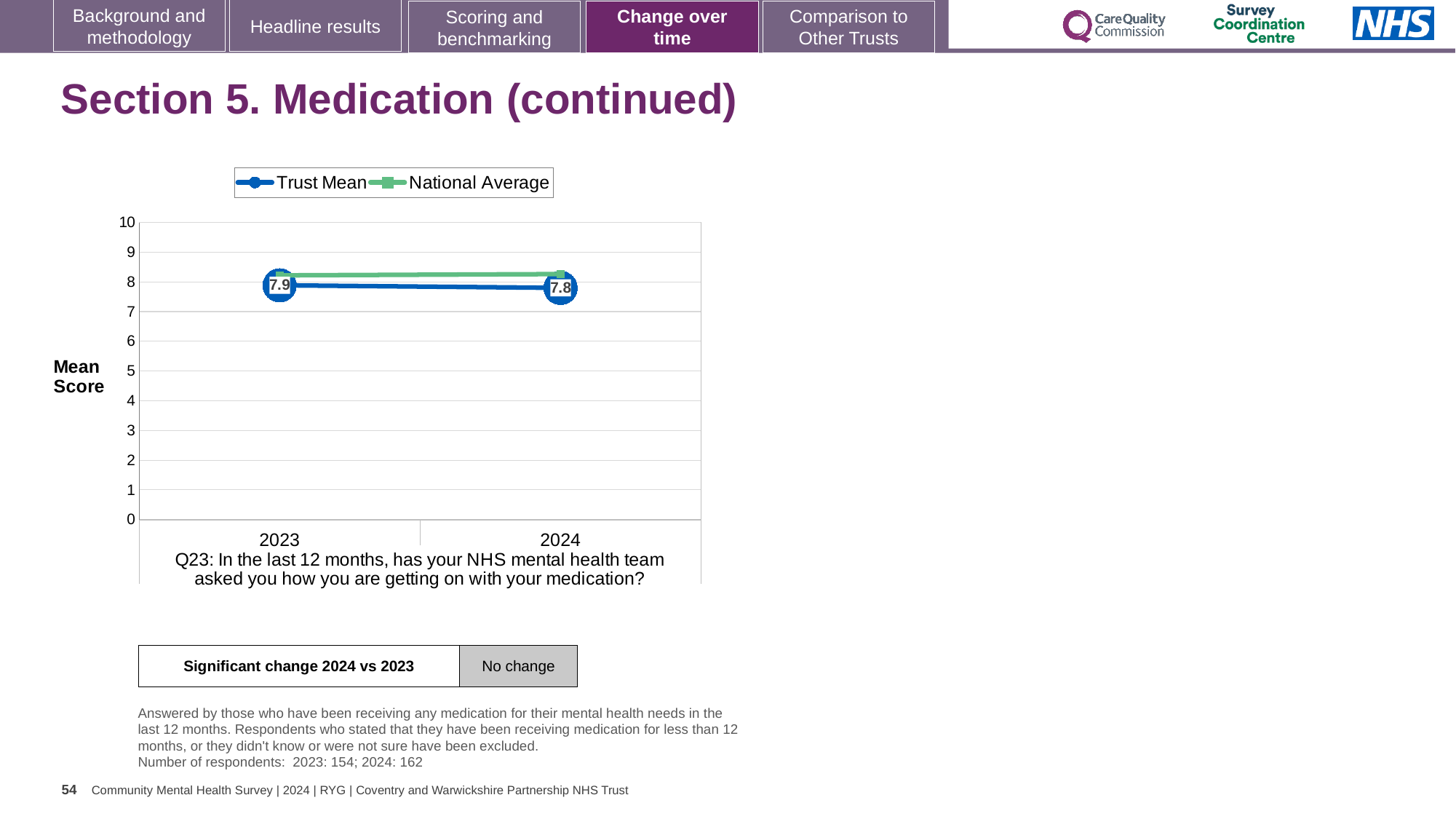
How many years are plotted on the x axis of the chart? 2 Which year has the higher Trust Mean score, 2023 or 2024? 2023 How many series does the chart legend list? 2 What is the Trust Mean score for 2023? 7.9 What is the difference between the Trust Mean scores for 2023 and 2024? 0.1 Is the National Average value for 2024 greater or less than 7? greater What is the Trust Mean score for 2024? 7.8 Does the Trust Mean rise or fall from 2023 to 2024? fall Which year has the lower Trust Mean score? 2024 What is the label on the y axis of the chart? Mean Score What kind of chart is shown on the slide? line chart In 2024, which series is higher, Trust Mean or National Average? National Average